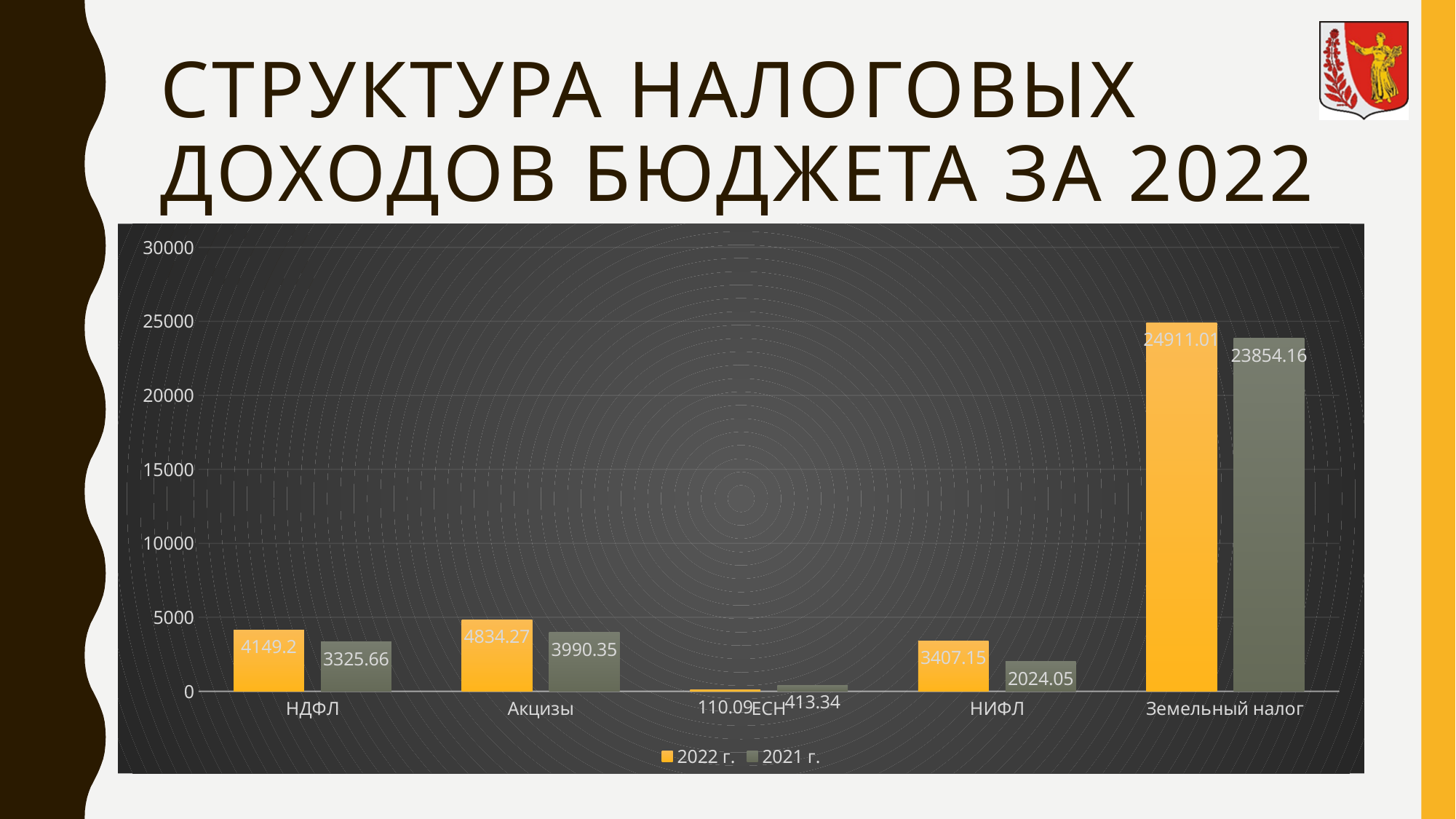
For ЕСН, which series has the larger value, 2022 г. or 2021 г.? 2021 г. Which category has the lowest value in the 2021 г. series? ЕСН What is the difference between the 2022 г. and 2021 г. values for Земельный налог? 1056.85 How many series does the legend list? 2 What kind of chart is shown on the slide? bar chart What is the value for ЕСН in the 2022 г. series? 110.09 What is the value for НИФЛ in the 2021 г. series? 2024.05 How many categories are shown on the x axis? 5 What is the value for Акцизы in the 2021 г. series? 3990.35 What is the value for НДФЛ in the 2022 г. series? 4149.2 Which category has the highest value in the 2022 г. series? Земельный налог Is the 2021 г. value for Земельный налог greater or less than 20000? greater